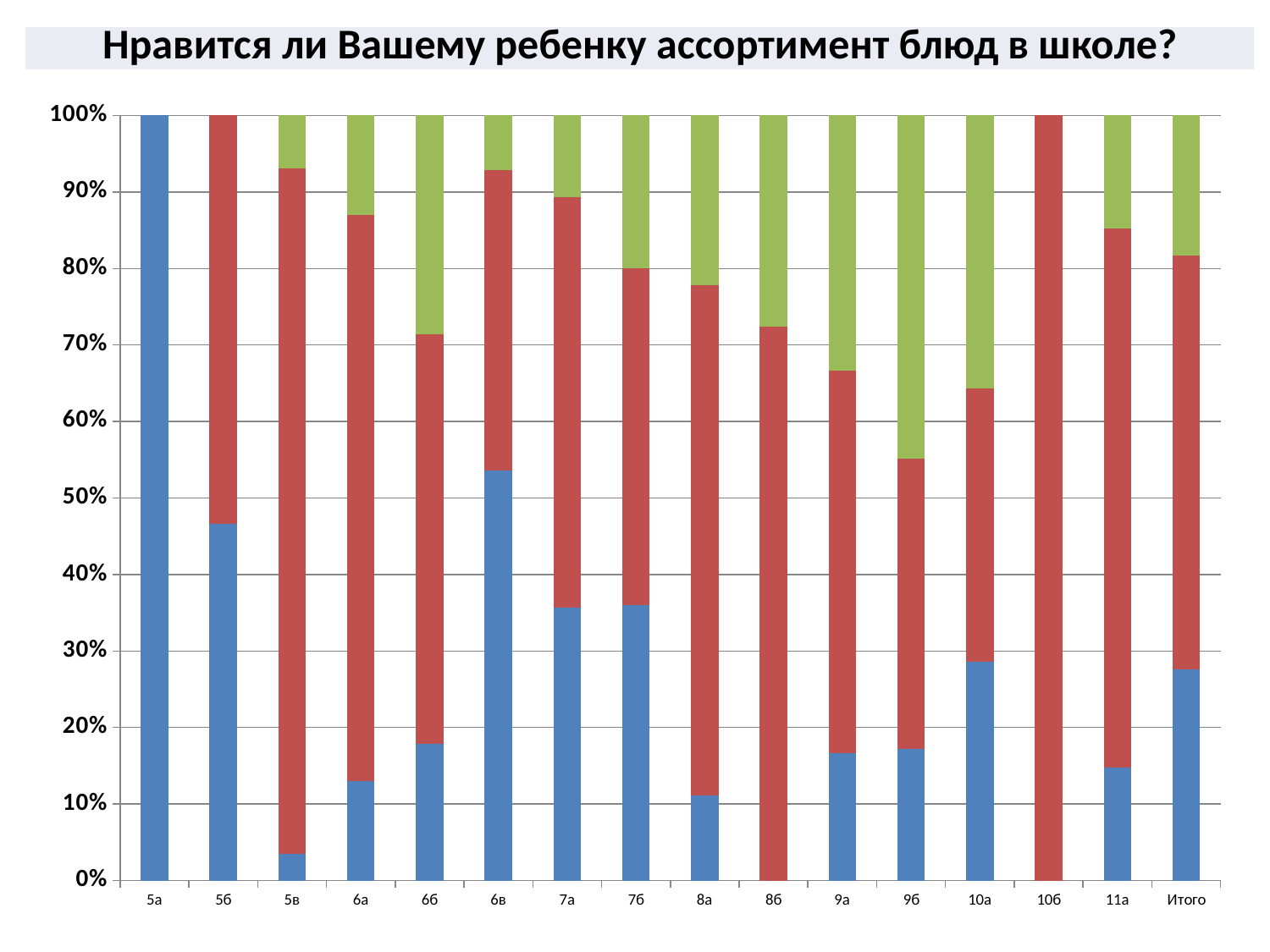
Which is larger, the blue segment for 6в or the blue segment for 7а? 6в Which category has the largest blue segment? 5а Is the blue segment for 6в greater or less than 50%? greater What is the value of the blue segment for 5а? 100% Is the blue segment for 5в greater or less than 10%? less What kind of chart is shown on the slide? Stacked bar chart How many categories are shown along the x axis? 16 Which categories have no blue segment at all? 8б and 10б What is the title of the chart? Нравится ли Вашему ребенку ассортимент блюд в школе? Which category has the largest green segment? 9б What is the value of the red segment for 10б? 100% Is the blue segment for 8а greater or less than 20%? less